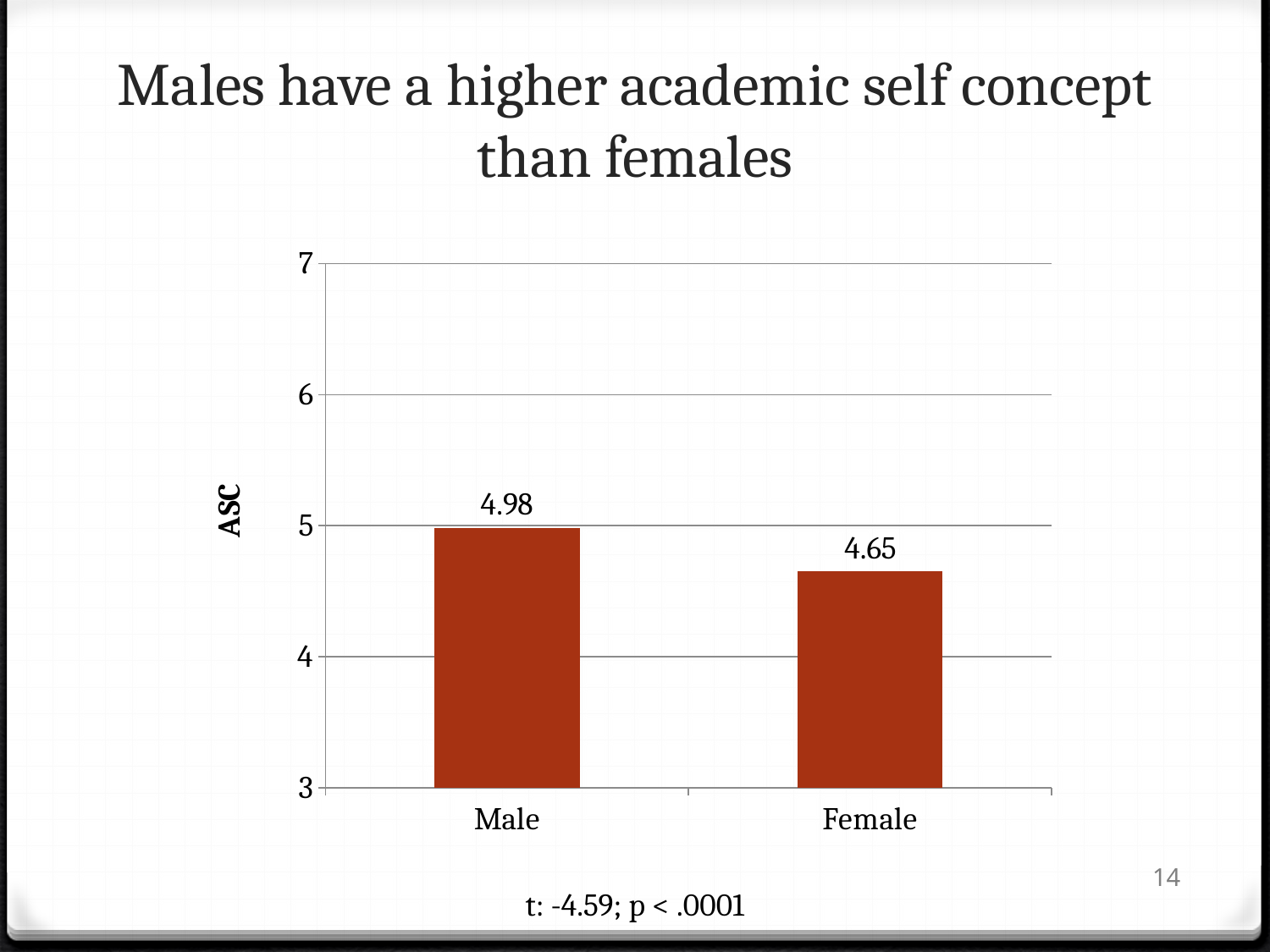
Which category has the higher ASC value? Male Is the value for Female greater or less than 5? less What is the difference between the ASC values for Male and Female? 0.33 Is the value for Male greater or less than 4? greater What is the title of the slide? Males have a higher academic self concept than females How many categories are shown on the x axis? 2 Is the ASC value for Male larger or smaller than the value for Female? larger What is the ASC value for Male? 4.98 What kind of chart is shown on the slide? bar chart Which category has the lower ASC value? Female What is the ASC value for Female? 4.65 What is the label on the vertical axis? ASC